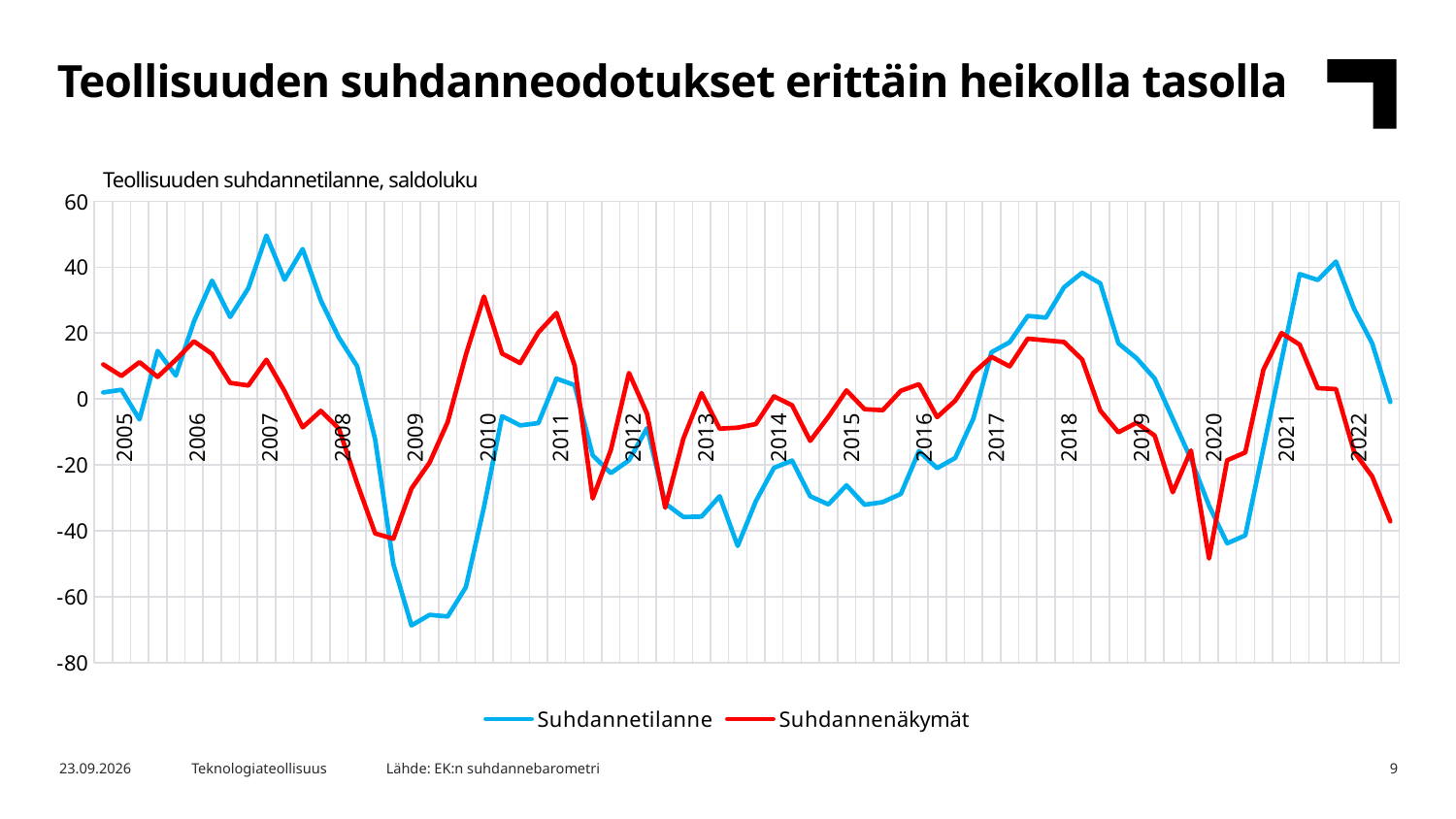
How many series does the legend list? 2 Is the peak of the Suhdannenäkymät series in 2010 greater or less than 20? greater Is the lowest value of the Suhdannetilanne series (around 2009) greater or less than -60? less How many year labels are shown on the x axis? 18 Is the lowest value of the Suhdannenäkymät series (around 2020) greater or less than -40? less What are the two series named in the legend? Suhdannetilanne and Suhdannenäkymät What is the title printed above the chart? Teollisuuden suhdannetilanne, saldoluku What kind of chart is shown on the slide? line chart At the end of 2022, which series has the higher value, Suhdannetilanne or Suhdannenäkymät? Suhdannetilanne Does the Suhdannenäkymät series rise or fall from its 2021 peak to the end of 2022? fall Which series reaches the lower minimum value over the whole period, Suhdannetilanne or Suhdannenäkymät? Suhdannetilanne